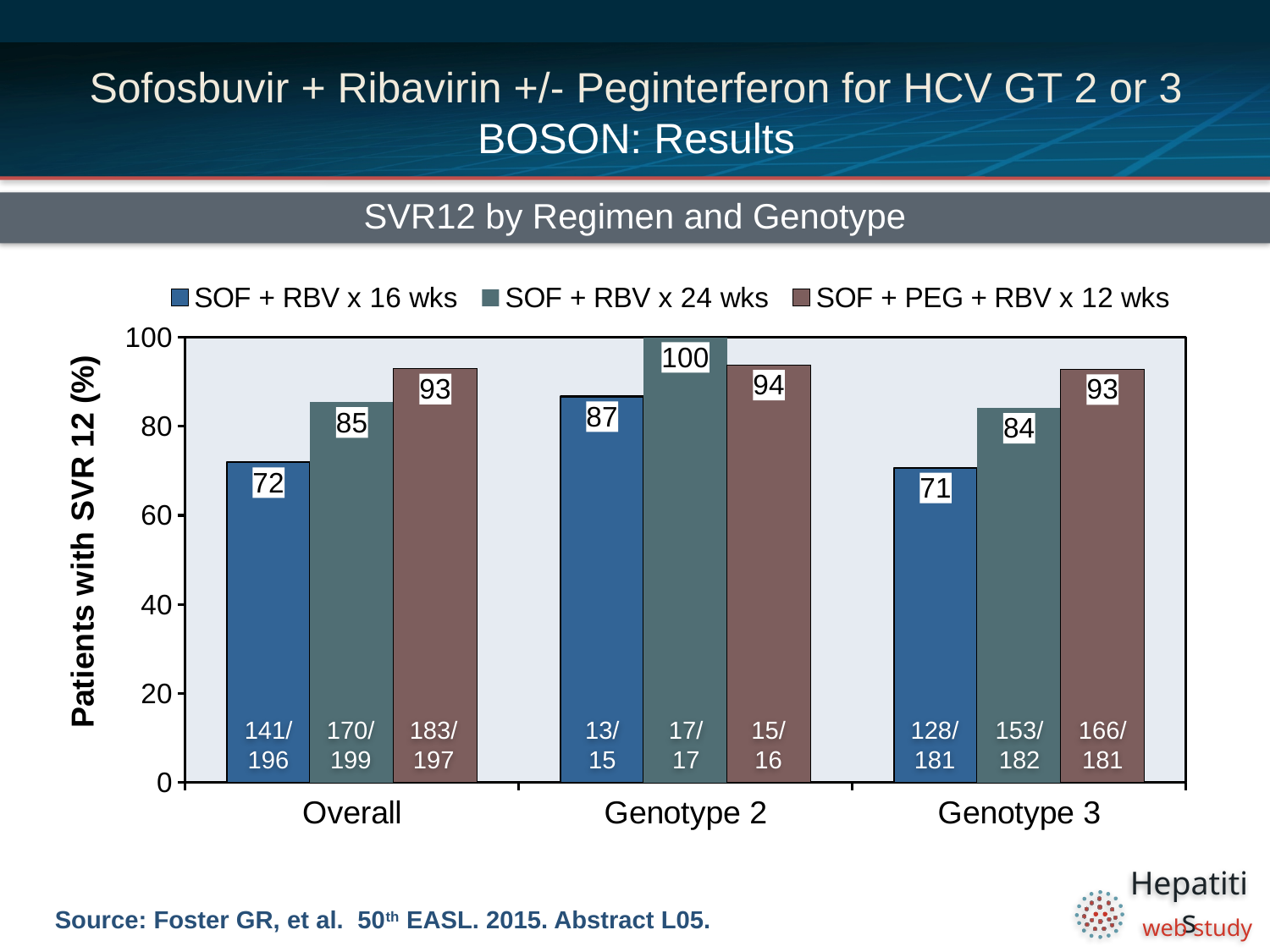
How many series does the legend list? 3 What is the difference in SVR12 rate between SOF + PEG + RBV x 12 wks and SOF + RBV x 16 wks in the Overall group? 21 What is the label of the y axis? Patients with SVR 12 (%) How many genotype categories are shown on the x axis? 3 What is the SVR12 rate for SOF + RBV x 24 wks in Genotype 2? 100 Which regimen has the highest SVR12 rate in Genotype 3? SOF + PEG + RBV x 12 wks What is the SVR12 rate for SOF + PEG + RBV x 12 wks in Genotype 3? 93 Which regimen has the lowest SVR12 rate in the Overall group? SOF + RBV x 16 wks What kind of chart is shown on the slide? Bar chart What is the title of the chart? SVR12 by Regimen and Genotype What is the SVR12 rate for SOF + RBV x 16 wks in the Overall group? 72 Which is larger: the SVR12 rate for SOF + RBV x 24 wks in Genotype 2 or in Genotype 3? Genotype 2